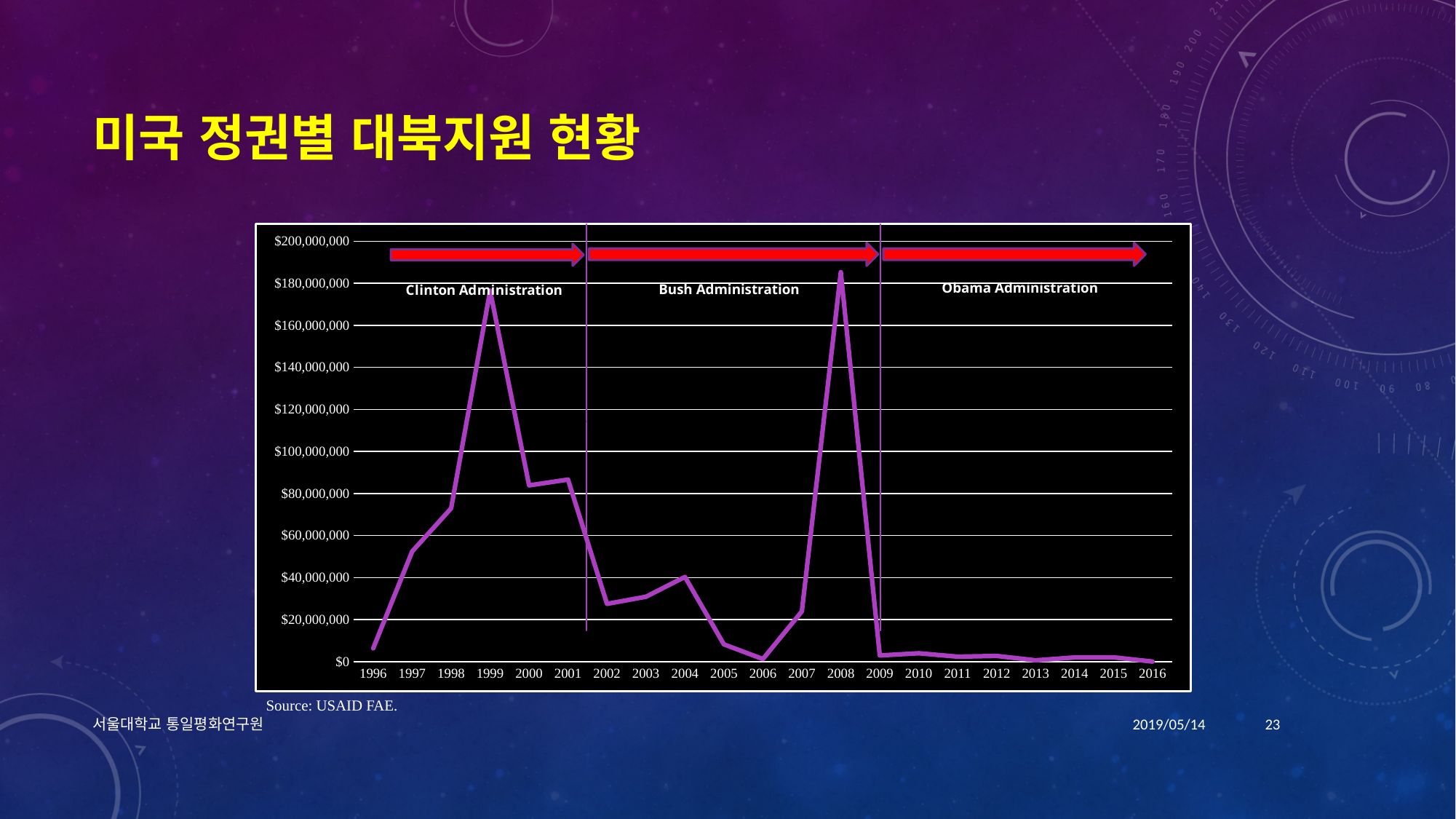
Is the value for 2008 greater or less than $180,000,000? greater Which year has the highest value on the chart? 2008 What kind of chart is shown on the slide? line chart Is the value for 1999 greater or less than $160,000,000? greater Which is larger, the value for 1999 or the value for 2000? 1999 Is the value for 2005 greater or less than $20,000,000? less Do the values rise or fall from 1996 to 1999? rise Which is larger, the value for 2003 or the value for 2005? 2003 Which three administrations are labeled across the top of the chart? Clinton Administration, Bush Administration, Obama Administration How many years are plotted along the x axis of the chart? 21